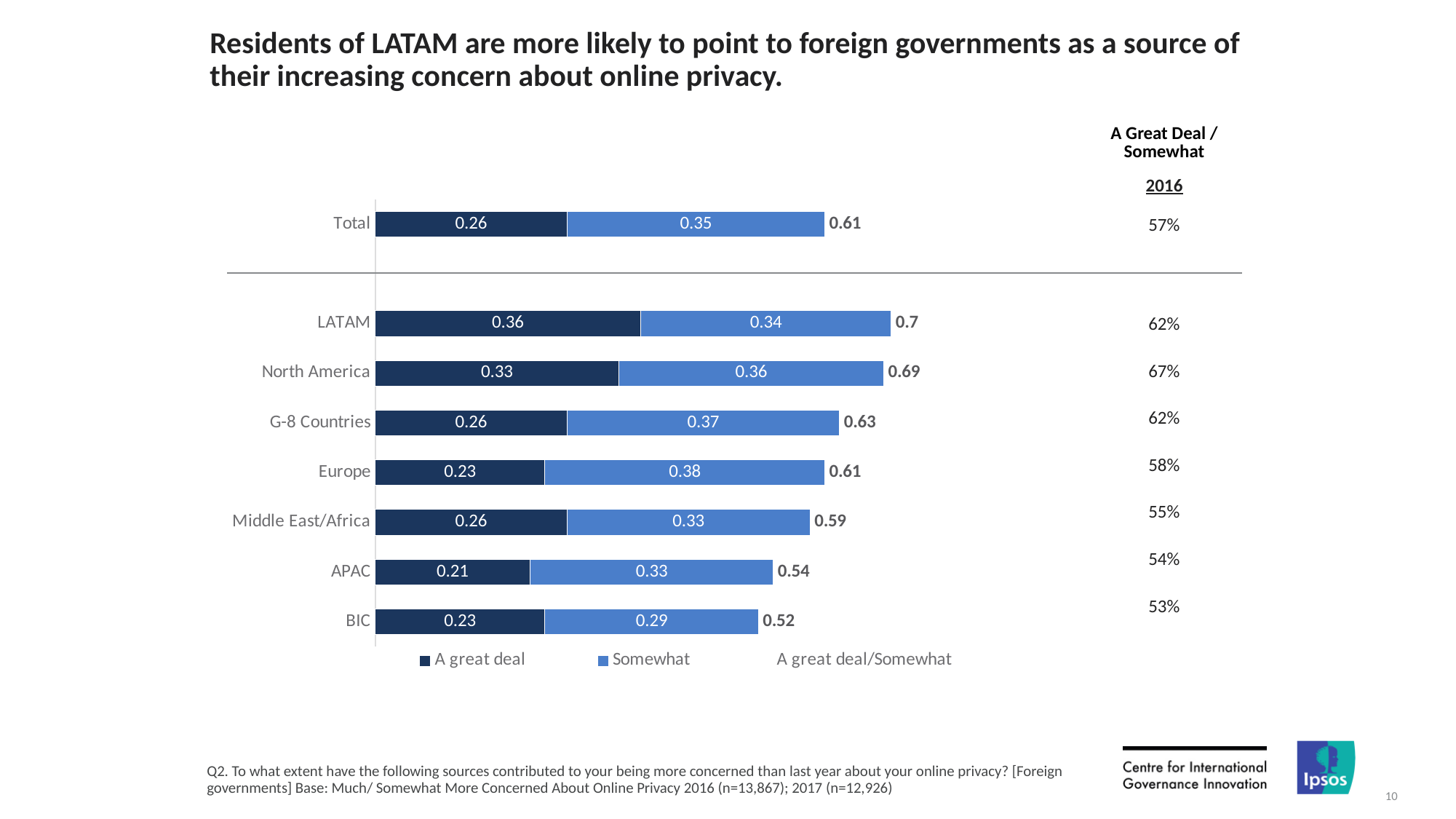
What is the difference between the combined values for LATAM and BIC? 0.18 What is the 2016 'A Great Deal / Somewhat' percentage shown for North America? 67% What kind of chart is shown on the slide? Stacked bar chart What is the total of the stacked bar for G-8 Countries? 0.63 What is the combined 'A great deal/Somewhat' value for North America? 0.69 What is the 'Somewhat' value for Europe? 0.38 Which region has the lowest combined 'A great deal/Somewhat' value? BIC How many series does the legend list? 3 How many regional categories are shown below the Total bar? 7 Which region has the highest combined 'A great deal/Somewhat' value? LATAM What is the 'A great deal' value for LATAM? 0.36 Which is larger, the 'A great deal' value for APAC or for Middle East/Africa? Middle East/Africa